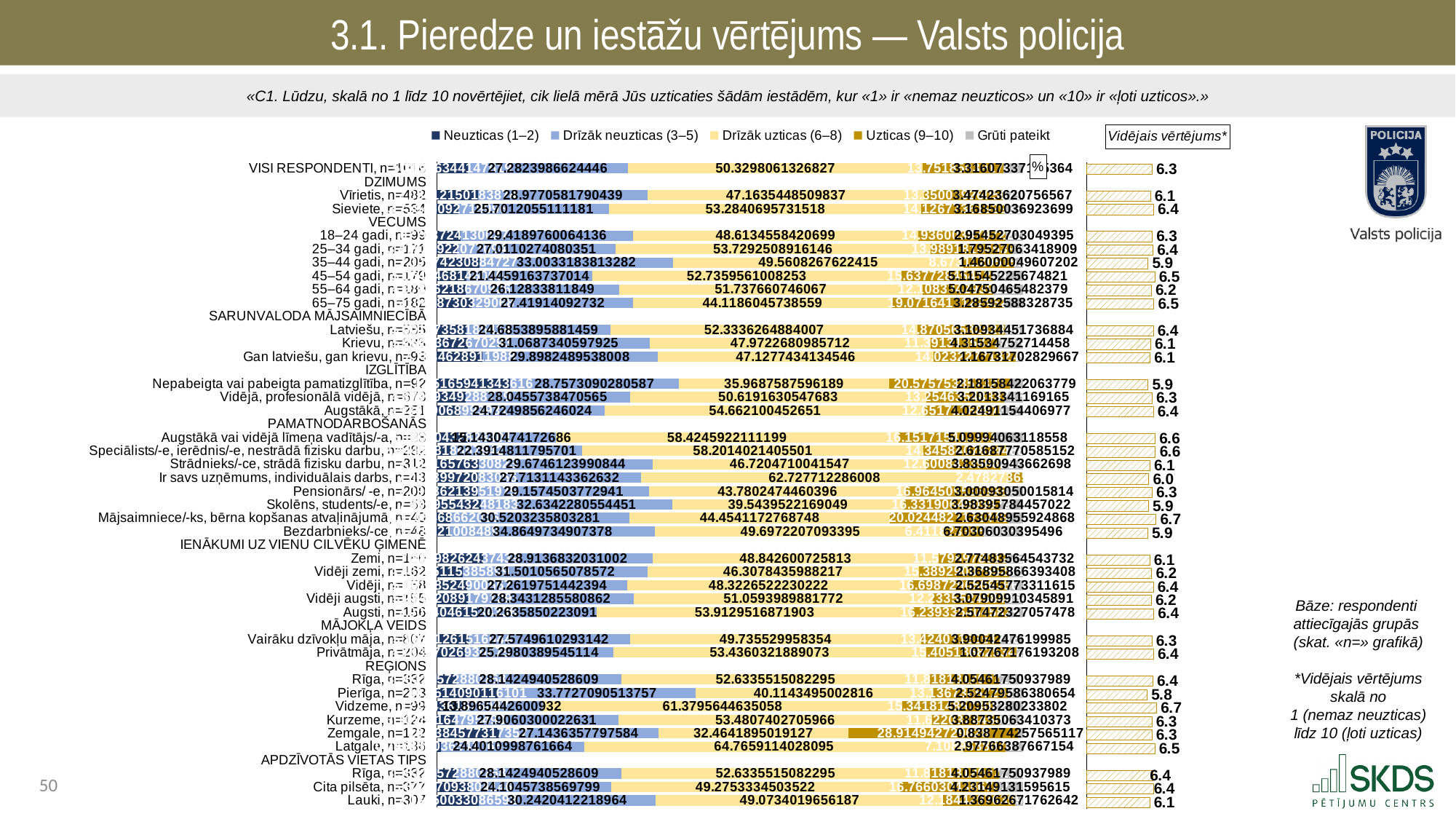
Among the REĢIONS groups, which has the lowest average rating? Pierīga Among the REĢIONS groups, which has the highest average rating? Vidzeme What is the average rating (Vidējais vērtējums) for Pierīga? 5.8 What kind of chart is shown on the slide? Stacked bar chart How many series does the legend list? 5 Which has the higher average rating, Vīrietis or Sieviete? Sieviete What is the average rating (Vidējais vērtējums) for VISI RESPONDENTI? 6.3 What is the Drīzāk uzticas (6–8) value for Latgale? 64.7659114028095 Which group has the lowest Drīzāk uzticas (6–8) share? Zemgale What is the difference between the average ratings of Vidzeme and Pierīga? 0.9 What is the average rating (Vidējais vērtējums) for Vidzeme? 6.7 What is the first legend entry of the chart? Neuzticas (1–2)